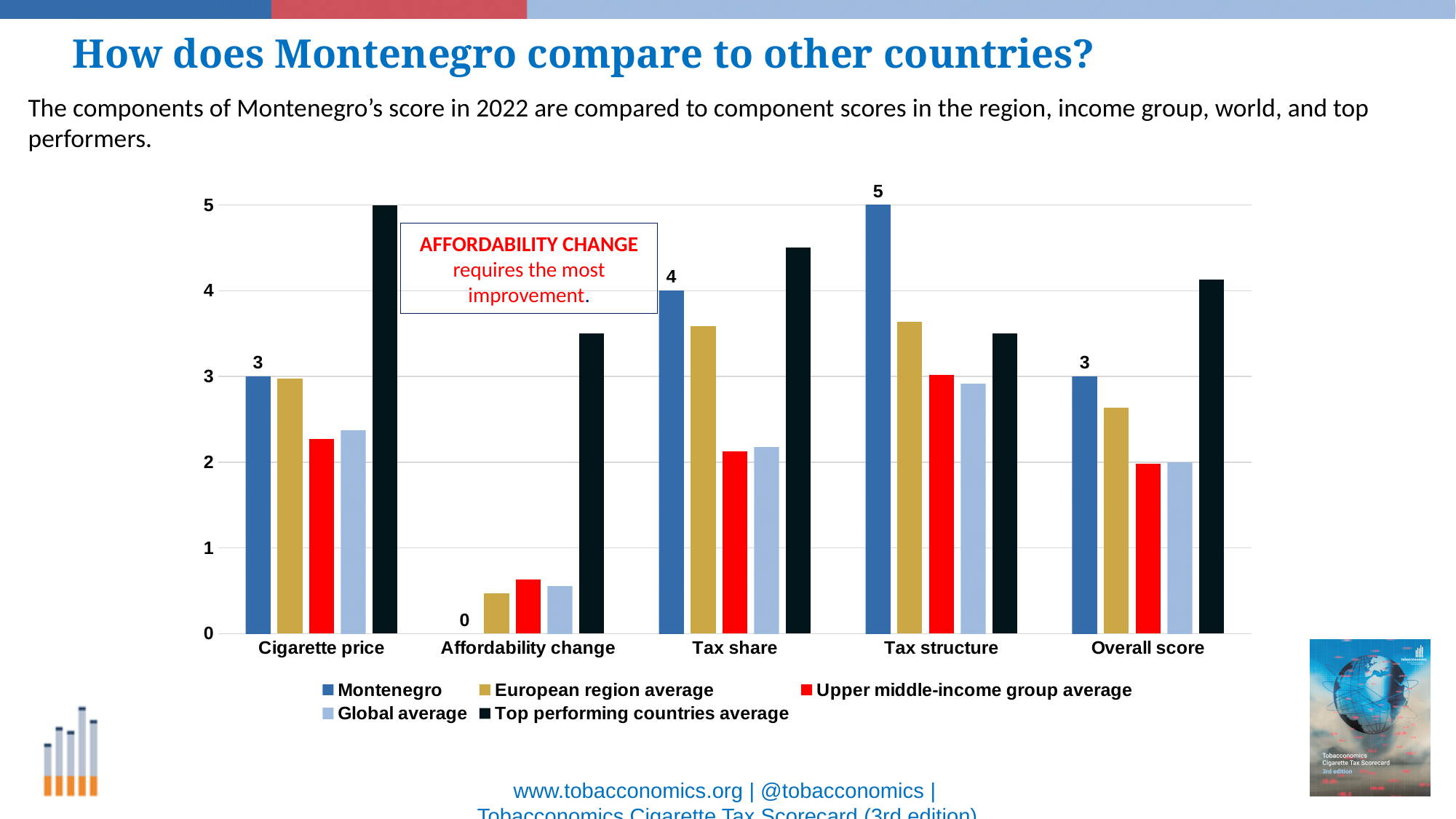
Which is larger for Montenegro: the Tax share score or the Overall score? Tax share What is Montenegro's score for Cigarette price? 3 What is Montenegro's score for Tax share? 4 In which category does Montenegro have its highest score? Tax structure Is the European region average for Overall score greater or less than 3? less How many series does the legend list? 5 How many categories are shown on the x axis? 5 In which category does Montenegro have its lowest score? Affordability change What is Montenegro's score for Tax structure? 5 What is the difference between Montenegro's Tax structure score and its Cigarette price score? 2 Is the Top performing countries average for Tax share greater or less than 4? greater What is Montenegro's score for Affordability change? 0